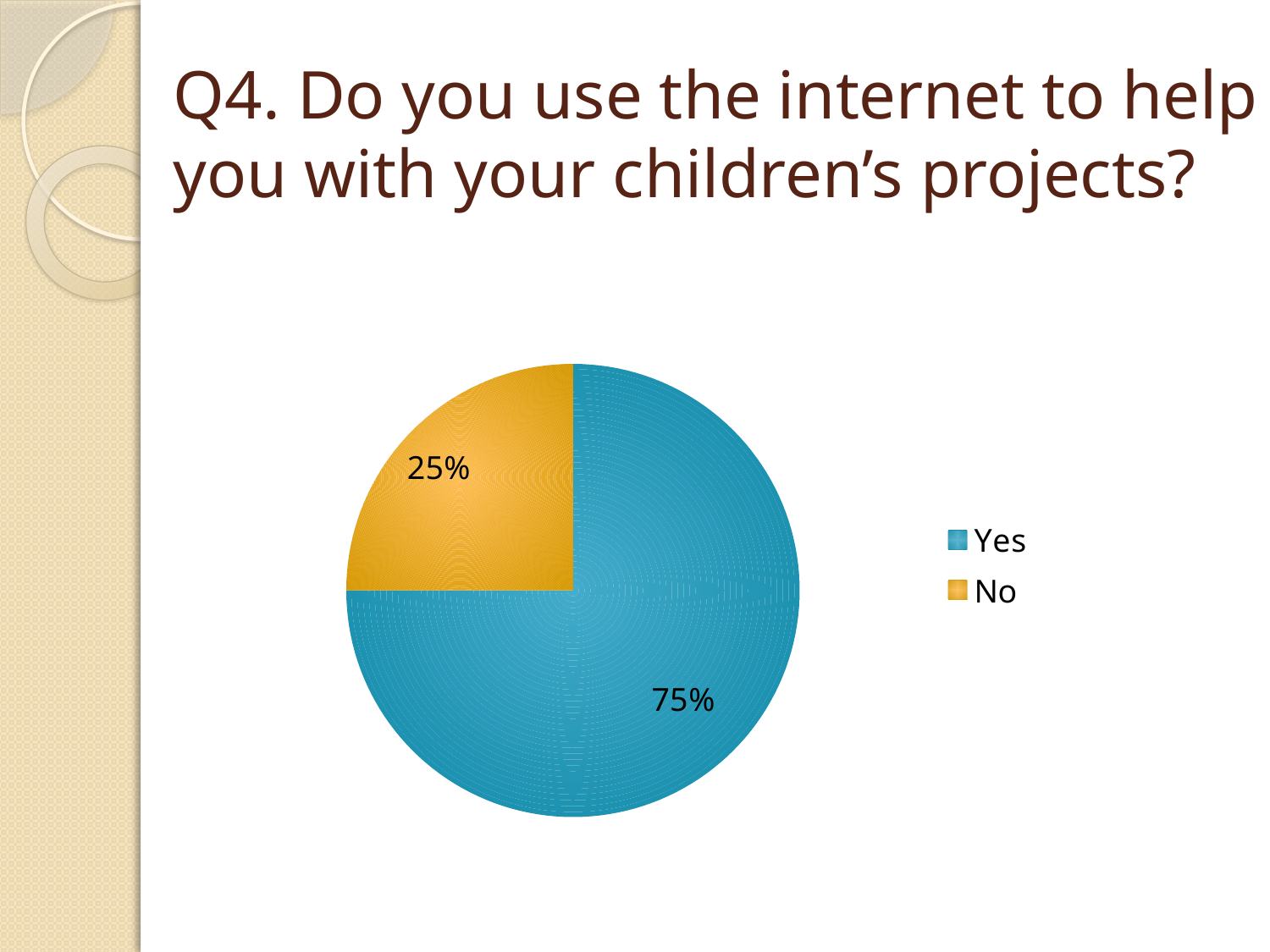
What is the title of the slide containing the pie chart? Q4. Do you use the internet to help you with your children's projects? What percentage of the pie is labelled for the No slice? 25% How many entries does the legend list? 2 How many slices does the pie chart have? 2 What is the difference in percentage points between the Yes and No slices? 50 Which slice of the pie is the smallest? No What percentage of the pie is labelled for the Yes slice? 75% What colour is the Yes slice in the pie chart? blue Which slice of the pie is the largest? Yes What share of the pie does the No slice represent? 25% Which is larger, the Yes slice or the No slice? Yes What kind of chart is shown on the slide? pie chart